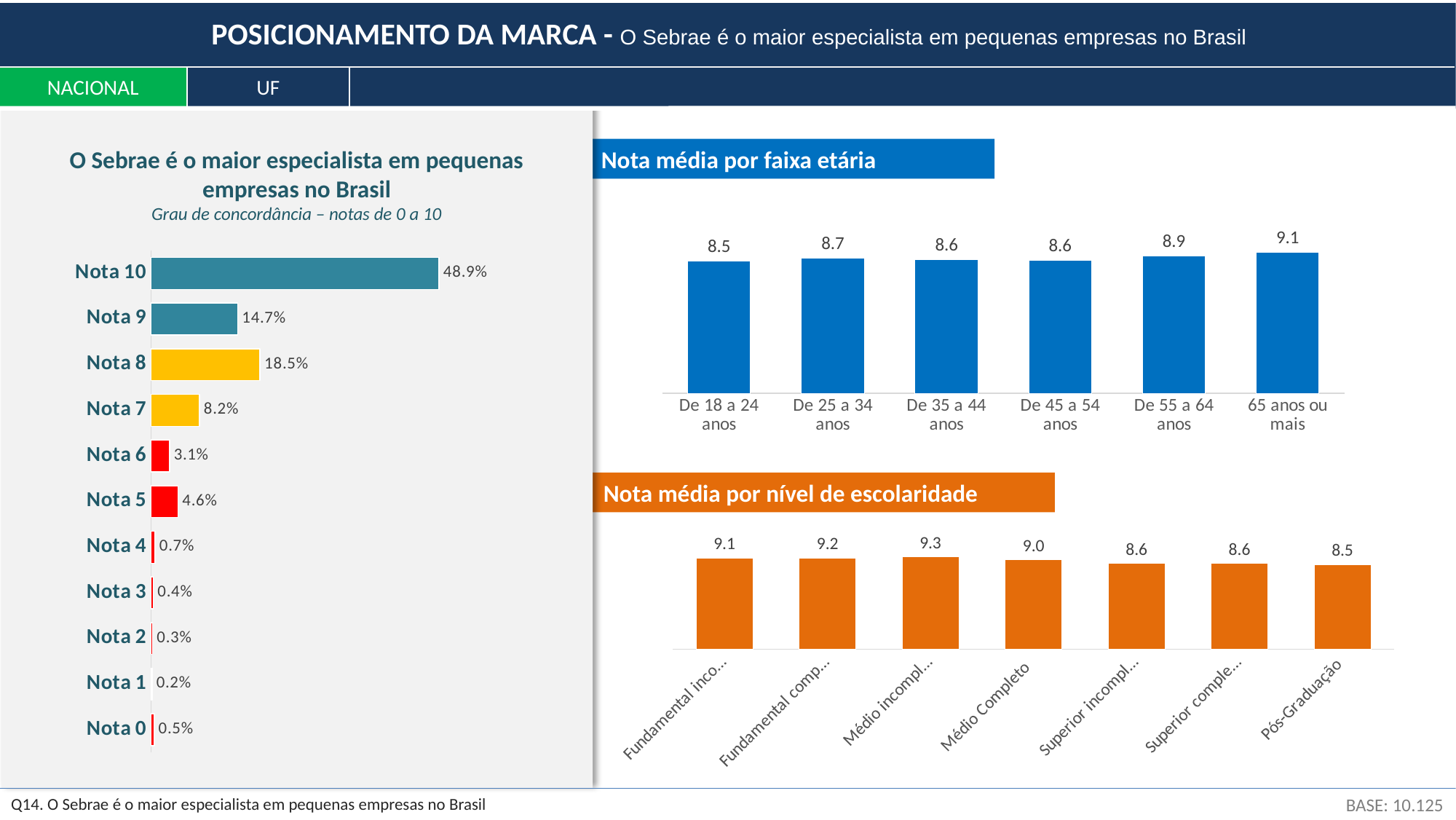
In the chart 'Nota média por nível de escolaridade', what is the value for 'Pós-Graduação'? 8.5 In the chart 'O Sebrae é o maior especialista em pequenas empresas no Brasil', what is the value for Nota 8? 18.5% In the chart 'Nota média por faixa etária', how many age groups are shown? 6 In the chart 'Nota média por nível de escolaridade', what is the value for 'Médio Completo'? 9.0 In the chart 'Nota média por faixa etária', what is the value for 'De 55 a 64 anos'? 8.9 In the chart 'Nota média por faixa etária', what is the difference between '65 anos ou mais' and 'De 18 a 24 anos'? 0.6 In the chart 'O Sebrae é o maior especialista em pequenas empresas no Brasil', what is the difference between Nota 9 and Nota 7? 6.5% In the chart 'O Sebrae é o maior especialista em pequenas empresas no Brasil', which is larger, Nota 6 or Nota 5? Nota 5 In the chart 'O Sebrae é o maior especialista em pequenas empresas no Brasil', what is the value for Nota 10? 48.9% In the chart 'O Sebrae é o maior especialista em pequenas empresas no Brasil', which category has the lowest value? Nota 1 In the chart 'O Sebrae é o maior especialista em pequenas empresas no Brasil', how many categories are shown? 11 In the chart 'Nota média por faixa etária', which age group has the highest value? 65 anos ou mais